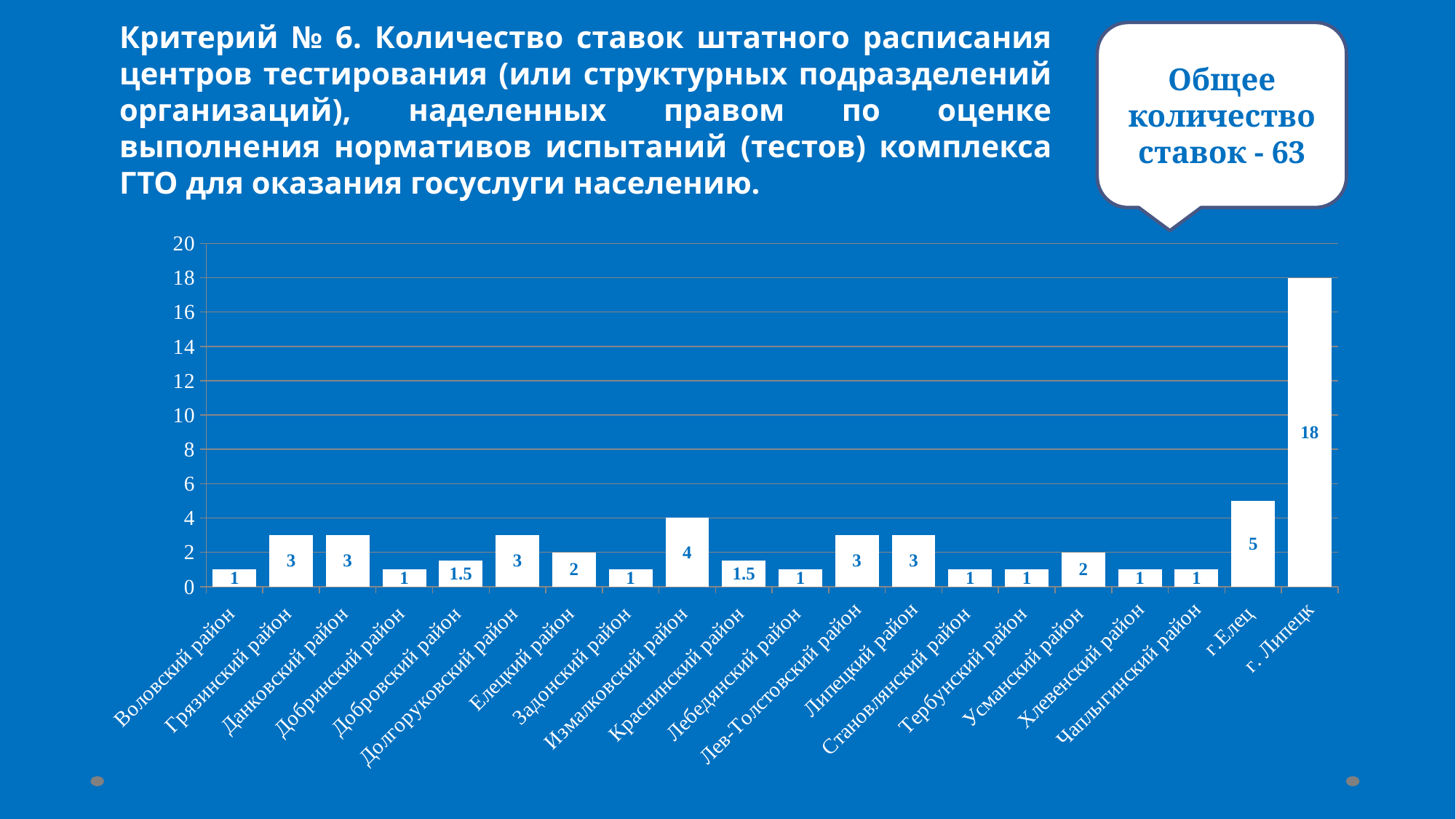
What is the value for г. Липецк? 18 Is the value for г. Липецк greater or less than 16? greater What total number of positions (ставок) is stated in the callout on the slide? 63 What is the value for г.Елец? 5 What type of chart is shown on the slide? bar chart Which category has the highest value in the chart? г. Липецк Which is larger, the value for Измалковский район or the value for Елецкий район? Измалковский район What is the value for Усманский район? 2 How many categories (districts/cities) are shown on the x axis of the chart? 20 What is the value for Измалковский район? 4 What is the value for Добровский район? 1.5 What is the difference between the values for г. Липецк and г.Елец? 13